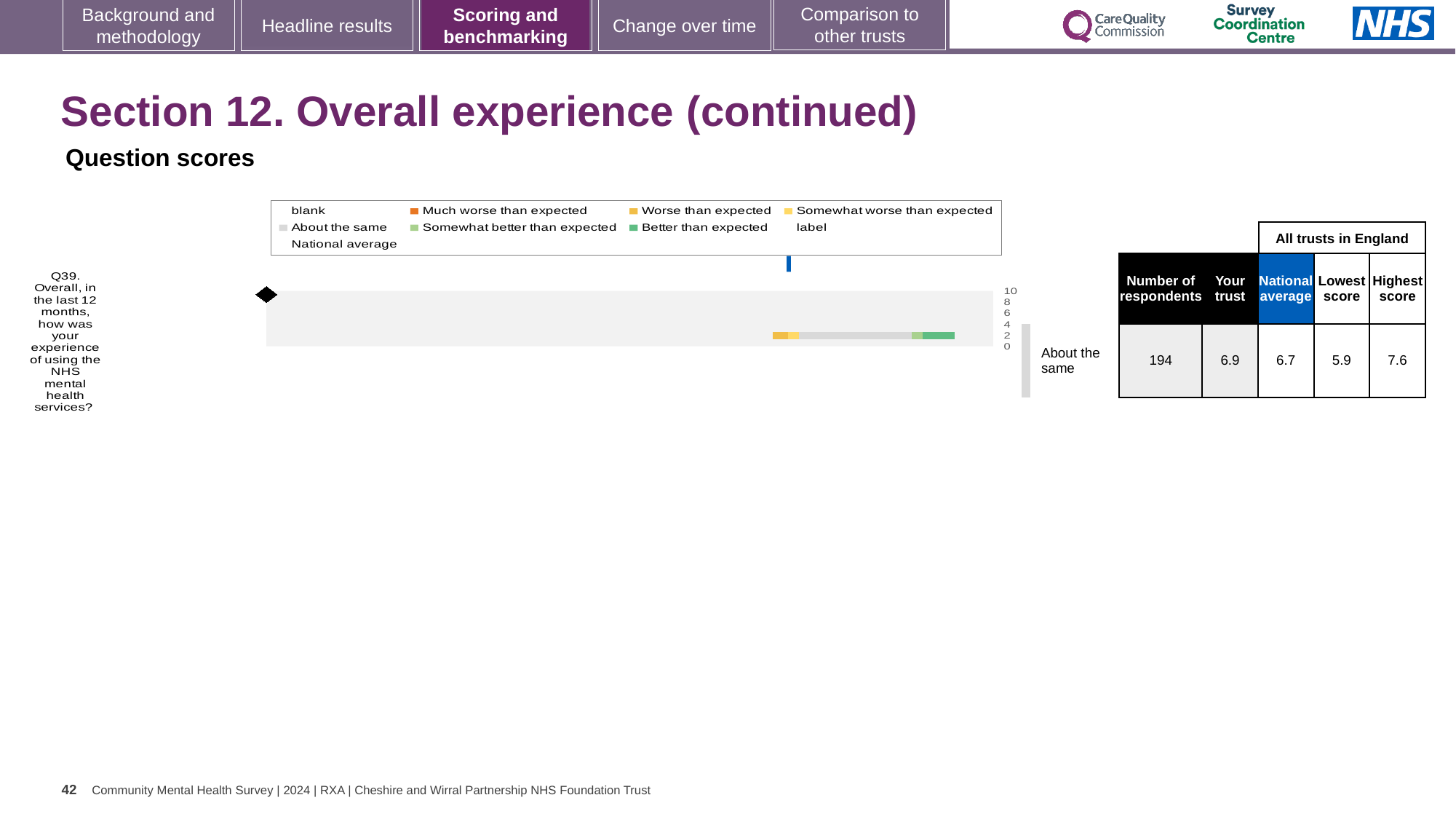
What is the highest score among all trusts in England for Q39? 7.6 What is the national average score for Q39 in the table? 6.7 How many entries does the chart legend list? 9 What kind of chart is used to show the Q39 question score? bar chart What is the lowest score among all trusts in England for Q39? 5.9 What is the maximum value shown on the chart's score axis? 10 What is the 'Your trust' score for Q39 in the table? 6.9 How many survey questions are plotted on the chart? 1 Is the 'Your trust' score for Q39 higher or lower than the national average? higher What is the difference between the highest score and the lowest score for Q39 across all trusts in England? 1.7 How many respondents answered Q39? 194 Which benchmark category is Q39 assigned to, according to the label next to the chart? About the same